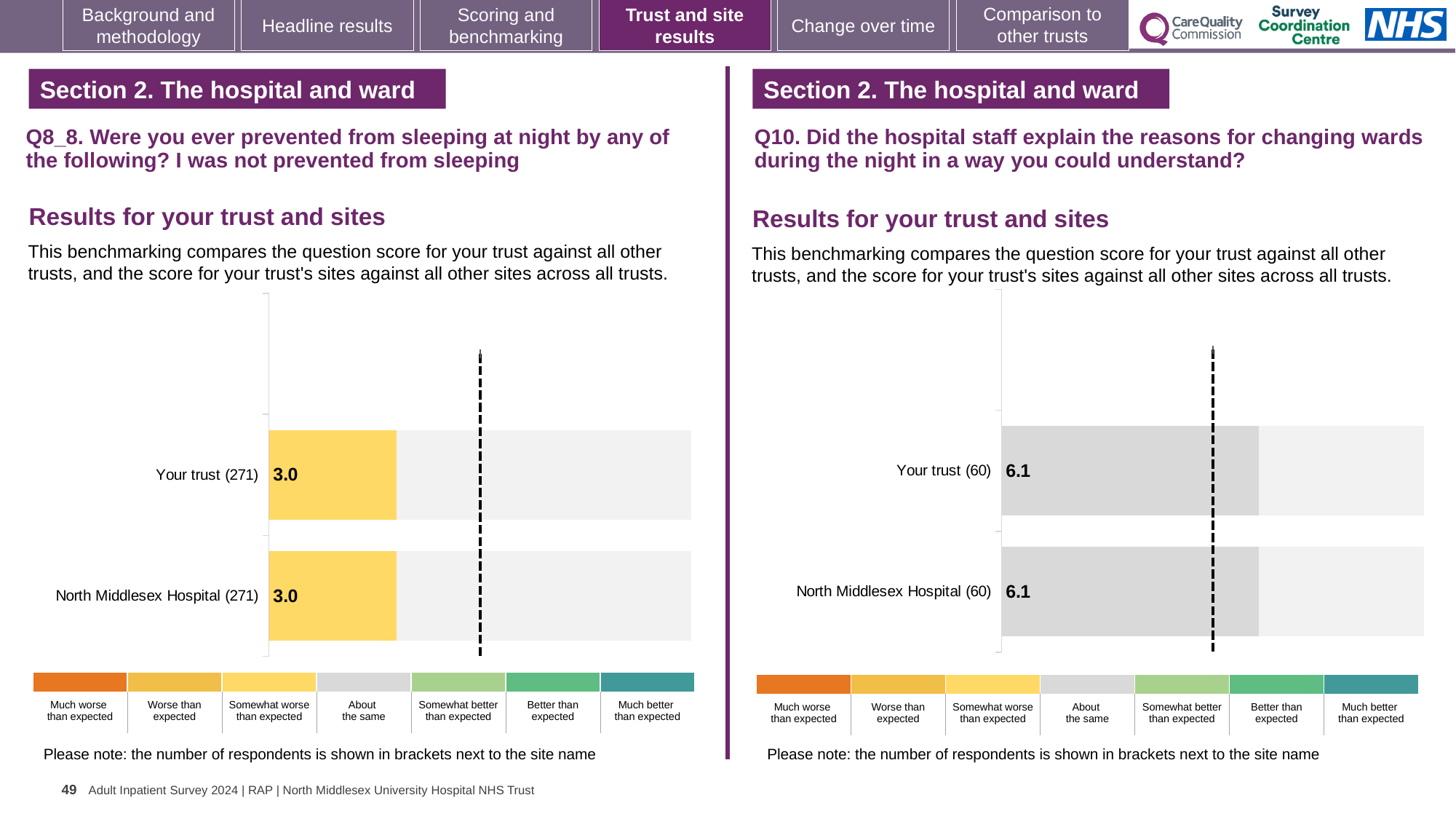
In the right chart (Q10), how many respondents are shown in brackets for North Middlesex Hospital? 60 In the left chart (Q8_8), what is the difference between the score for Your trust and the score for North Middlesex Hospital? 0.0 In the right chart (Q10), what is the score for North Middlesex Hospital? 6.1 In the left chart (Q8_8), which benchmark category does the colour of the bars correspond to? Somewhat worse than expected In the left chart (Q8_8), what is the score for Your trust? 3.0 What kind of chart is used on the left (Q8_8)? Bar chart In the right chart (Q10), what is the score for Your trust? 6.1 How many bars are plotted in the right chart (Q10)? 2 In the left chart (Q8_8), what is the score for North Middlesex Hospital? 3.0 In the right chart (Q10), what is the difference between the score for Your trust and the score for North Middlesex Hospital? 0.0 In the left chart (Q8_8), how many respondents are shown in brackets for Your trust? 271 How many bars are plotted in the left chart (Q8_8)? 2